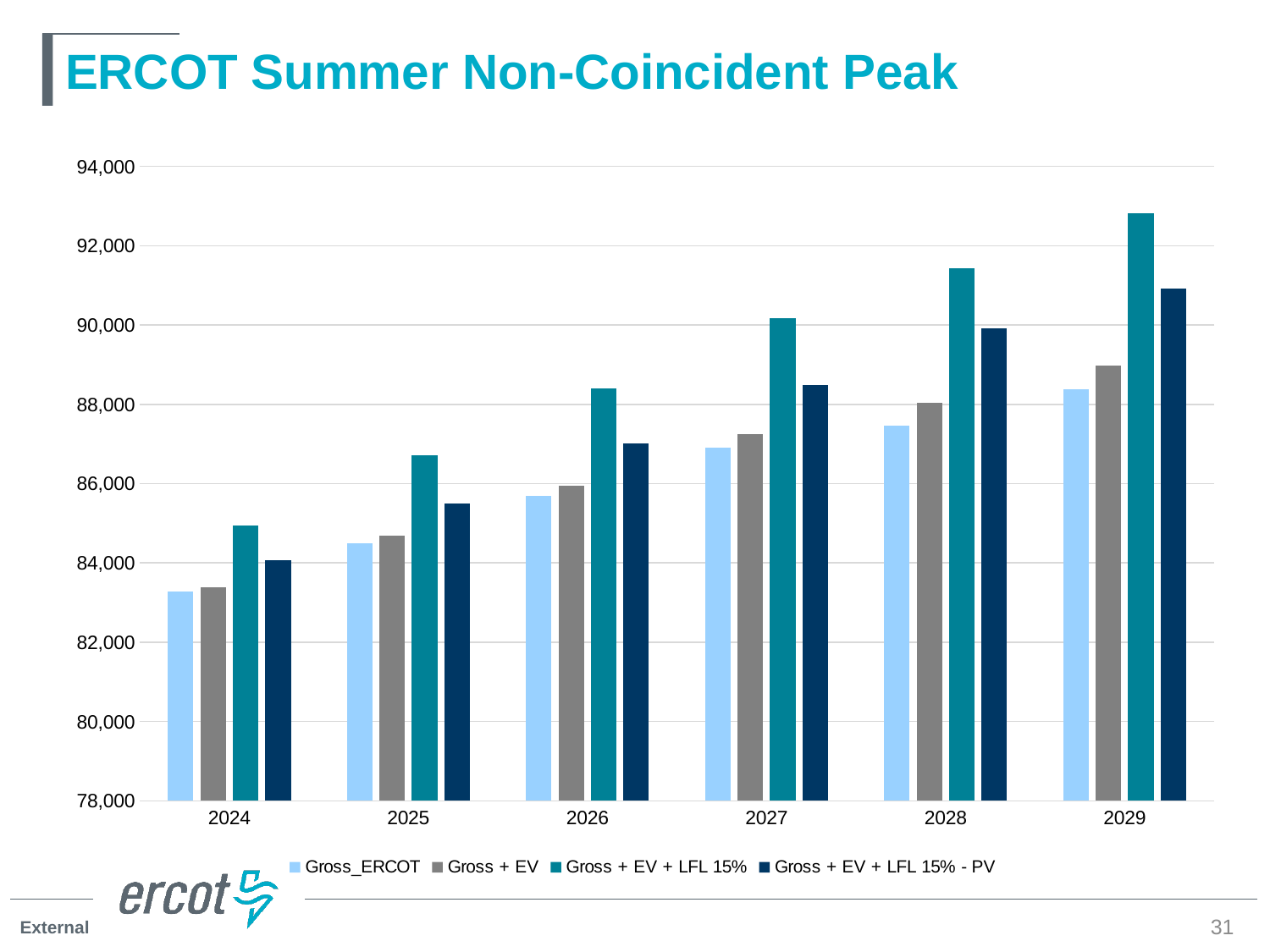
In which year is the Gross_ERCOT value lowest? 2024 What is the title of the chart? ERCOT Summer Non-Coincident Peak Does the Gross_ERCOT series rise or fall from 2024 to 2029? Rises Is the Gross + EV + LFL 15% value for 2029 greater or less than 92,000? greater How many series does the legend list? 4 What kind of chart is shown on the slide? Bar chart Is the Gross + EV + LFL 15% - PV value for 2026 greater or less than 88,000? less Is the Gross + EV value for 2029 greater or less than 88,000? greater How many years are shown on the x axis? 6 In which year is the Gross + EV + LFL 15% value highest? 2029 In 2027, which is larger: Gross + EV + LFL 15% or Gross + EV + LFL 15% - PV? Gross + EV + LFL 15%